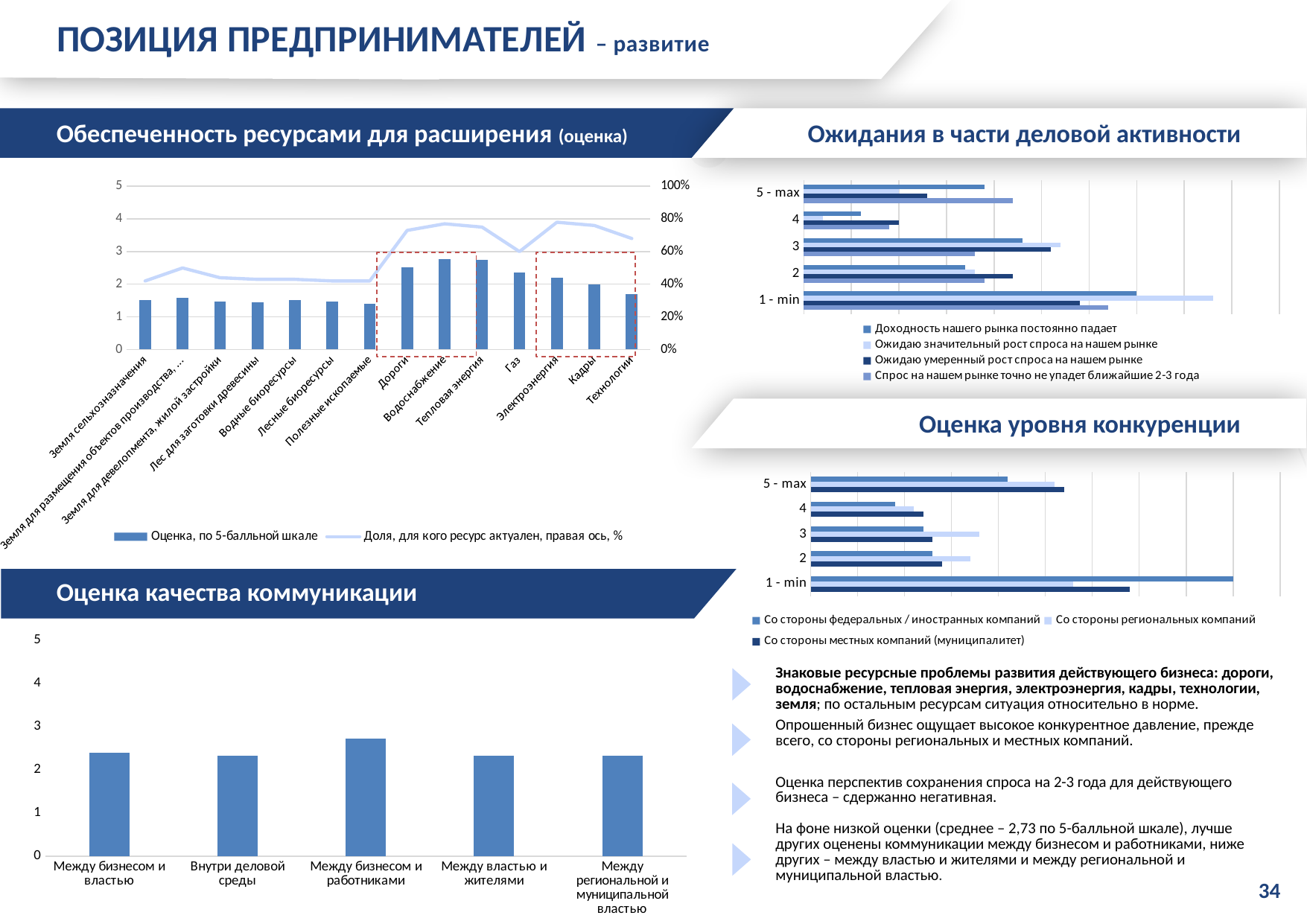
In the 'Оценка качества коммуникации' chart, which category has the highest value? Между бизнесом и работниками How many series does the legend of the 'Обеспеченность ресурсами для расширения (оценка)' chart list? 2 In the 'Обеспеченность ресурсами для расширения (оценка)' chart, is the bar value for 'Земля сельхозназначения' greater or less than 2? less How many series does the legend of the 'Ожидания в части деловой активности' chart list? 4 How many categories are shown on the vertical axis of the 'Оценка уровня конкуренции' chart? 5 How many categories are shown in the 'Оценка качества коммуникации' chart? 5 In the 'Обеспеченность ресурсами для расширения (оценка)' chart, which of the two bars is larger: 'Дороги' or 'Полезные ископаемые'? Дороги How many series does the legend of the 'Оценка уровня конкуренции' chart list? 3 What kind of chart is the 'Оценка качества коммуникации' chart? bar chart In the 'Оценка качества коммуникации' chart, is the value for 'Внутри деловой среды' greater or less than 2? greater In the 'Оценка качества коммуникации' chart, is the value for 'Между бизнесом и работниками' greater or less than 3? less